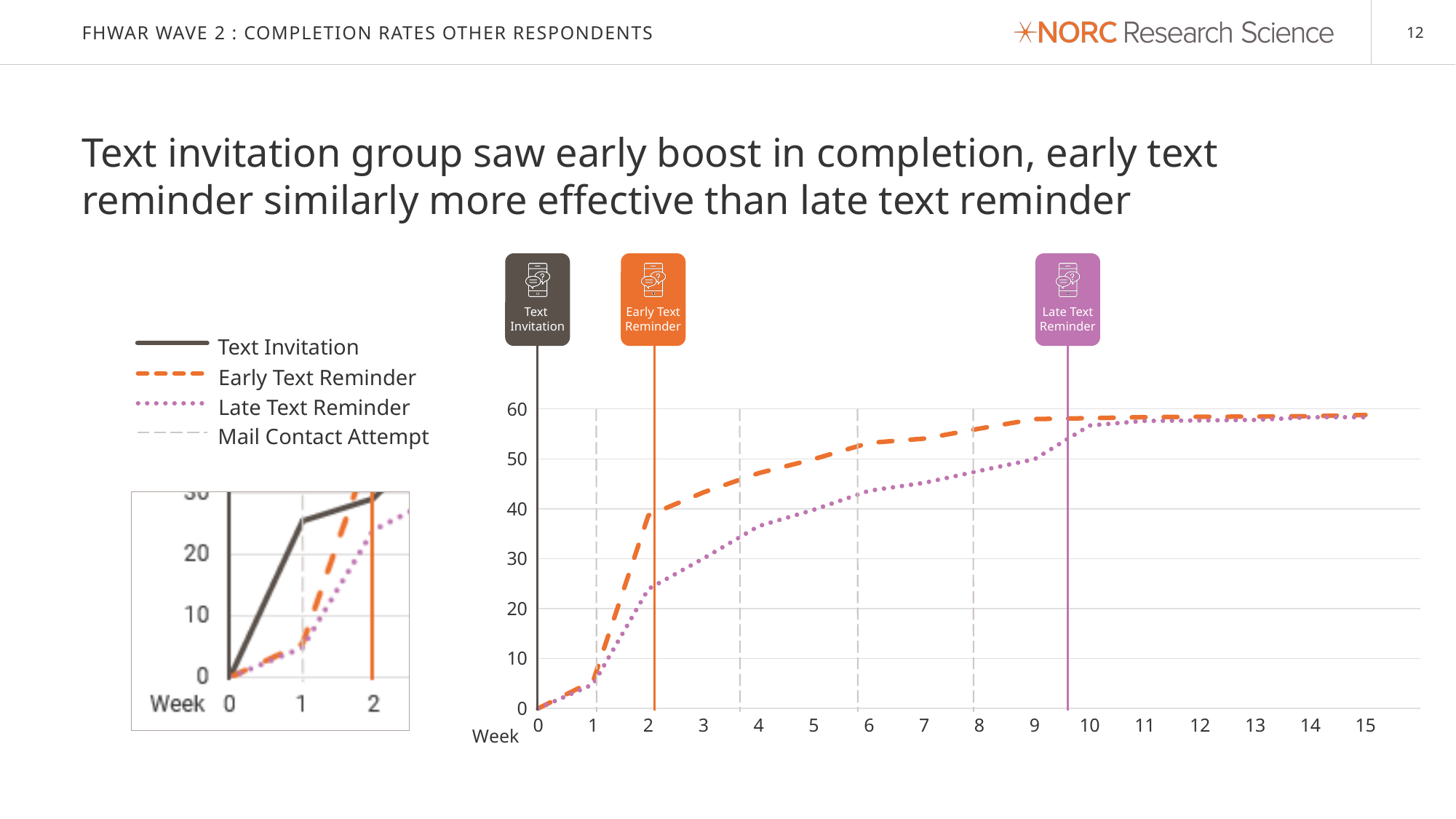
In the main chart, is the value for Early Text Reminder at week 8 greater or less than 50? greater What kind of chart is the main chart on the right? line chart In the main chart, do the plotted values rise or fall as the weeks increase? rise In the main chart, is the value for Late Text Reminder at week 4 greater or less than 40? less In the main chart, is the value for Early Text Reminder at week 4 greater or less than 40? greater In the main chart, which series is higher at week 4, Early Text Reminder or Late Text Reminder? Early Text Reminder How many entries does the legend list? 4 What is the label of the x axis on the main chart? Week What is the highest week shown on the x axis of the main chart? 15